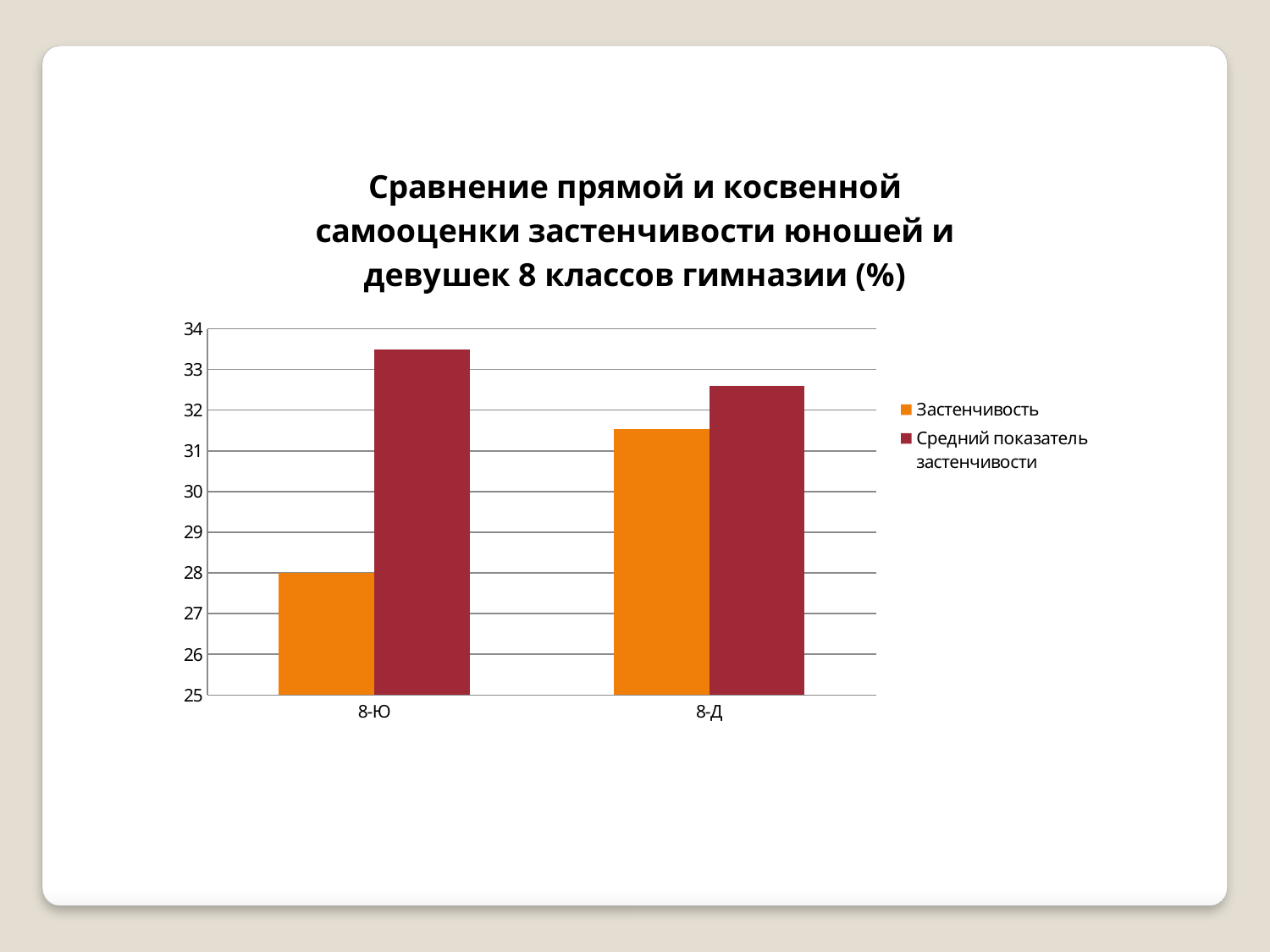
How many series does the chart's legend list? 2 Is the value of Средний показатель застенчивости for 8-Д greater or less than 33? less Which series is shown in orange in the chart's legend? Застенчивость How many categories are shown on the x axis of the chart? 2 What kind of chart is shown on the slide? Bar chart What is the title of the chart? Сравнение прямой и косвенной самооценки застенчивости юношей и девушек 8 классов гимназии (%) Is the value of Средний показатель застенчивости for 8-Ю greater or less than 33? greater What is the value of Застенчивость for 8-Ю? 28 Is the value of Застенчивость for 8-Д greater or less than 31? greater Which category has the higher value of Средний показатель застенчивости? 8-Ю Which category has the lower value of Застенчивость? 8-Ю For 8-Д, which is larger: Застенчивость or Средний показатель застенчивости? Средний показатель застенчивости